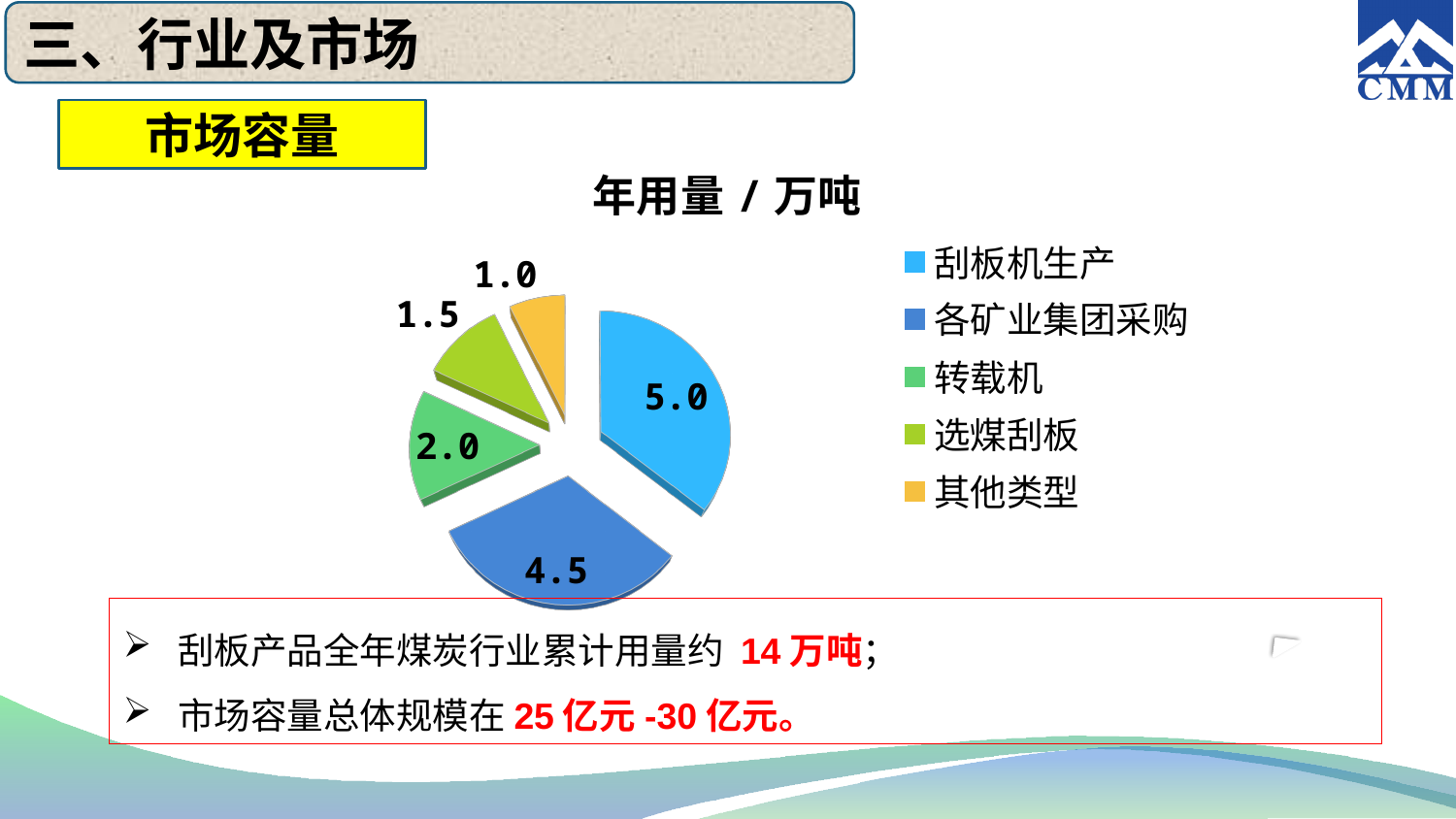
What is the value for 选煤刮板? 1.5 What is the value for 其他类型? 1.0 What is the value for 转载机? 2.0 Which is larger, the value for 转载机 or the value for 选煤刮板? 转载机 Which category has the largest slice? 刮板机生产 What is the title of the chart? 年用量 / 万吨 Which category has the smallest slice? 其他类型 What is the difference between the values for 刮板机生产 and 各矿业集团采购? 0.5 How many categories does the legend list? 5 What type of chart is shown on the slide? pie chart What is the value for 刮板机生产? 5.0 What is the value for 各矿业集团采购? 4.5